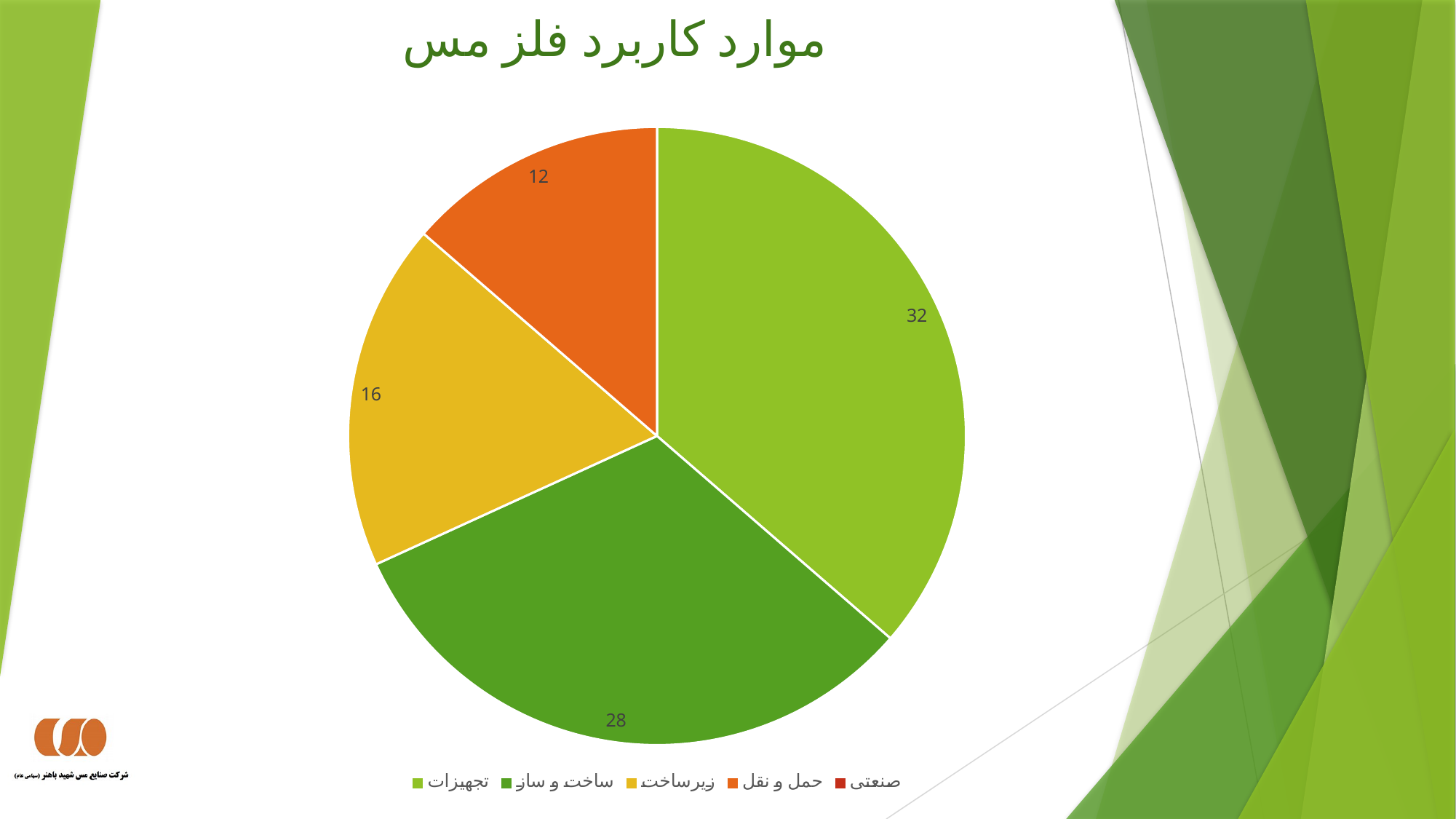
How many slices with data labels are shown in the pie chart? 4 Which category with a visible slice has the smallest value? حمل و نقل What is the title of the chart? موارد کاربرد فلز مس What is the value for زیرساخت? 16 What type of chart is shown on the slide? pie chart What is the value for حمل و نقل? 12 Which category has the largest slice of the pie? تجهیزات What is the value for تجهیزات? 32 What is the difference between the values for زیرساخت and حمل و نقل? 4 What is the difference between the values for تجهیزات and ساخت و ساز? 4 What is the value for ساخت و ساز? 28 Which is larger, the value for ساخت و ساز or the value for زیرساخت? ساخت و ساز